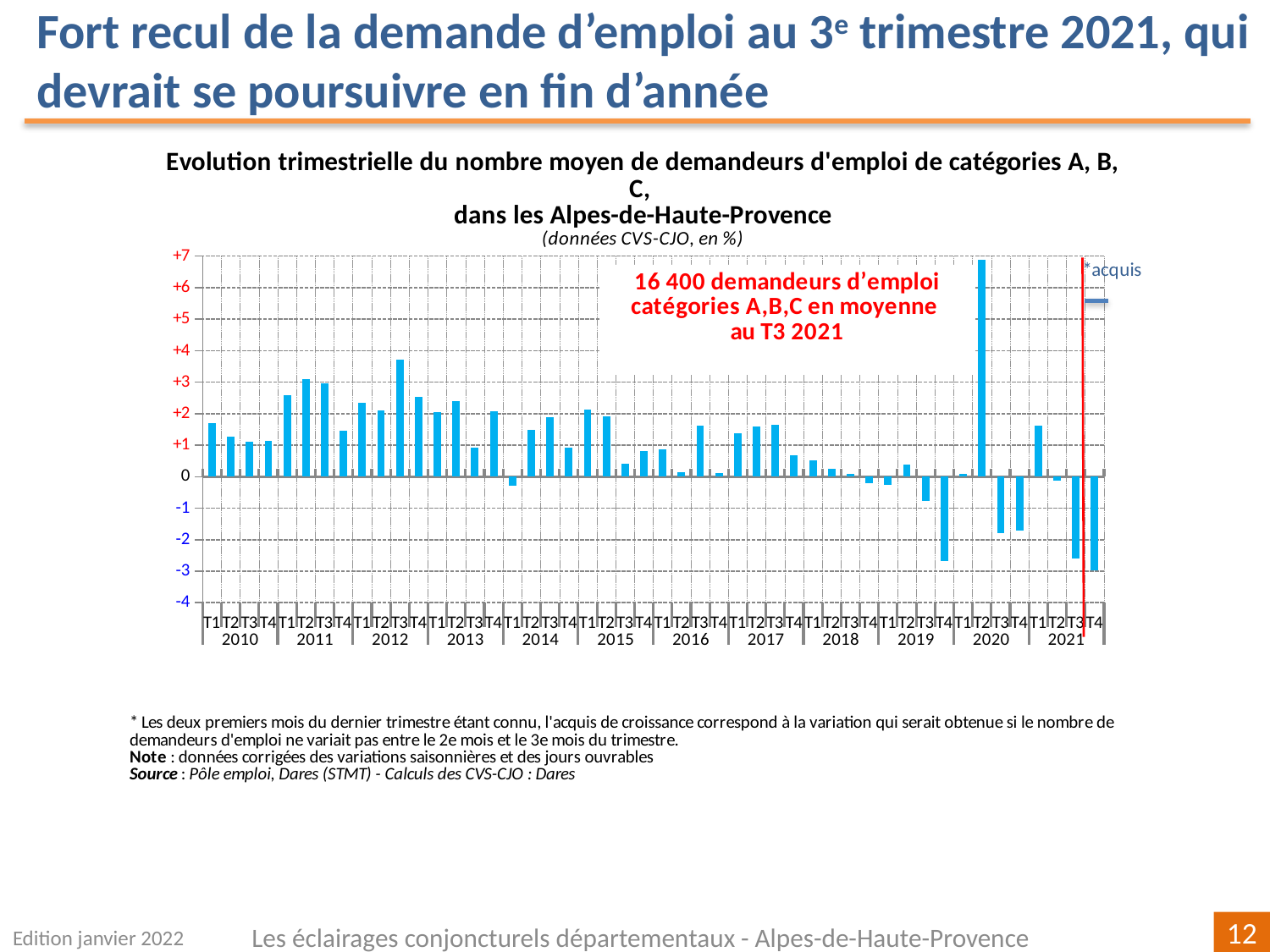
Is the value for T2 2011 greater or less than +2? greater How many years are shown on the x axis of the chart? 12 According to the annotation on the chart, how many demandeurs d'emploi catégories A,B,C were there on average in T3 2021? 16 400 Is the value for T4 2019 greater or less than -2? less Which quarter has the highest value in the chart? T2 2020 Which is larger, the value for T2 2020 or the value for T3 2020? T2 2020 Do the values rise or fall from T1 2021 to T4 2021? fall What kind of chart is shown on the slide? Bar chart Is the value for T3 2012 greater or less than +3? greater In which département does the chart say the data is measured? Alpes-de-Haute-Provence